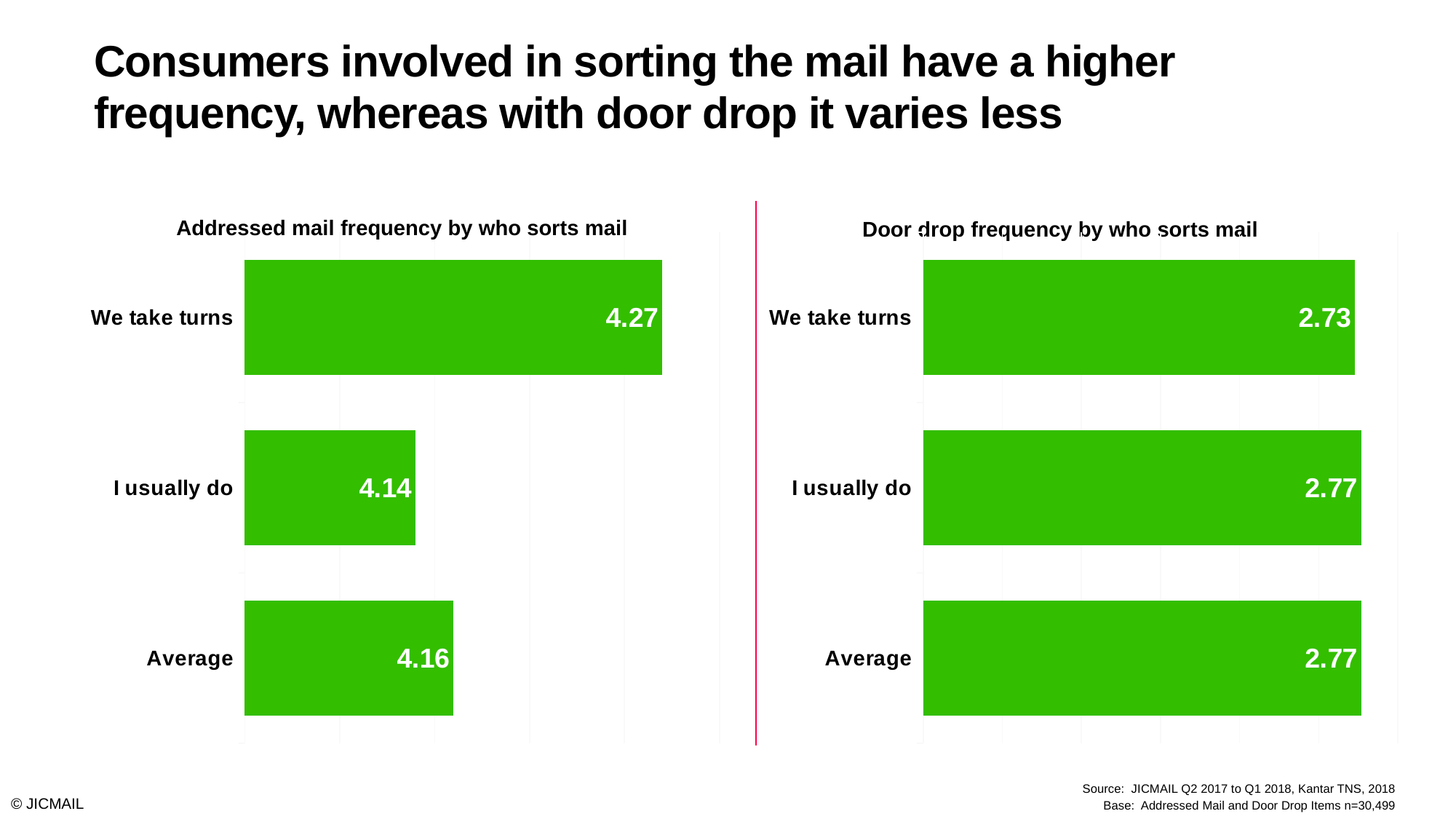
In the 'Addressed mail frequency by who sorts mail' chart, what is the value for 'We take turns'? 4.27 In the 'Door drop frequency by who sorts mail' chart, what is the value for 'We take turns'? 2.73 In the 'Door drop frequency by who sorts mail' chart, which category has the lowest value? We take turns In the 'Addressed mail frequency by who sorts mail' chart, which category has the lowest value? I usually do Which is larger: 'We take turns' in the 'Addressed mail frequency by who sorts mail' chart or 'We take turns' in the 'Door drop frequency by who sorts mail' chart? Addressed mail frequency by who sorts mail In the 'Door drop frequency by who sorts mail' chart, what is the value for 'Average'? 2.77 What type of chart is the 'Addressed mail frequency by who sorts mail' chart? Bar chart In the 'Addressed mail frequency by who sorts mail' chart, what is the value for 'I usually do'? 4.14 In the 'Addressed mail frequency by who sorts mail' chart, what is the difference between 'We take turns' and 'I usually do'? 0.13 In the 'Door drop frequency by who sorts mail' chart, what is the difference between 'I usually do' and 'We take turns'? 0.04 In the 'Addressed mail frequency by who sorts mail' chart, which category has the highest value? We take turns How many categories are shown in the 'Door drop frequency by who sorts mail' chart? 3